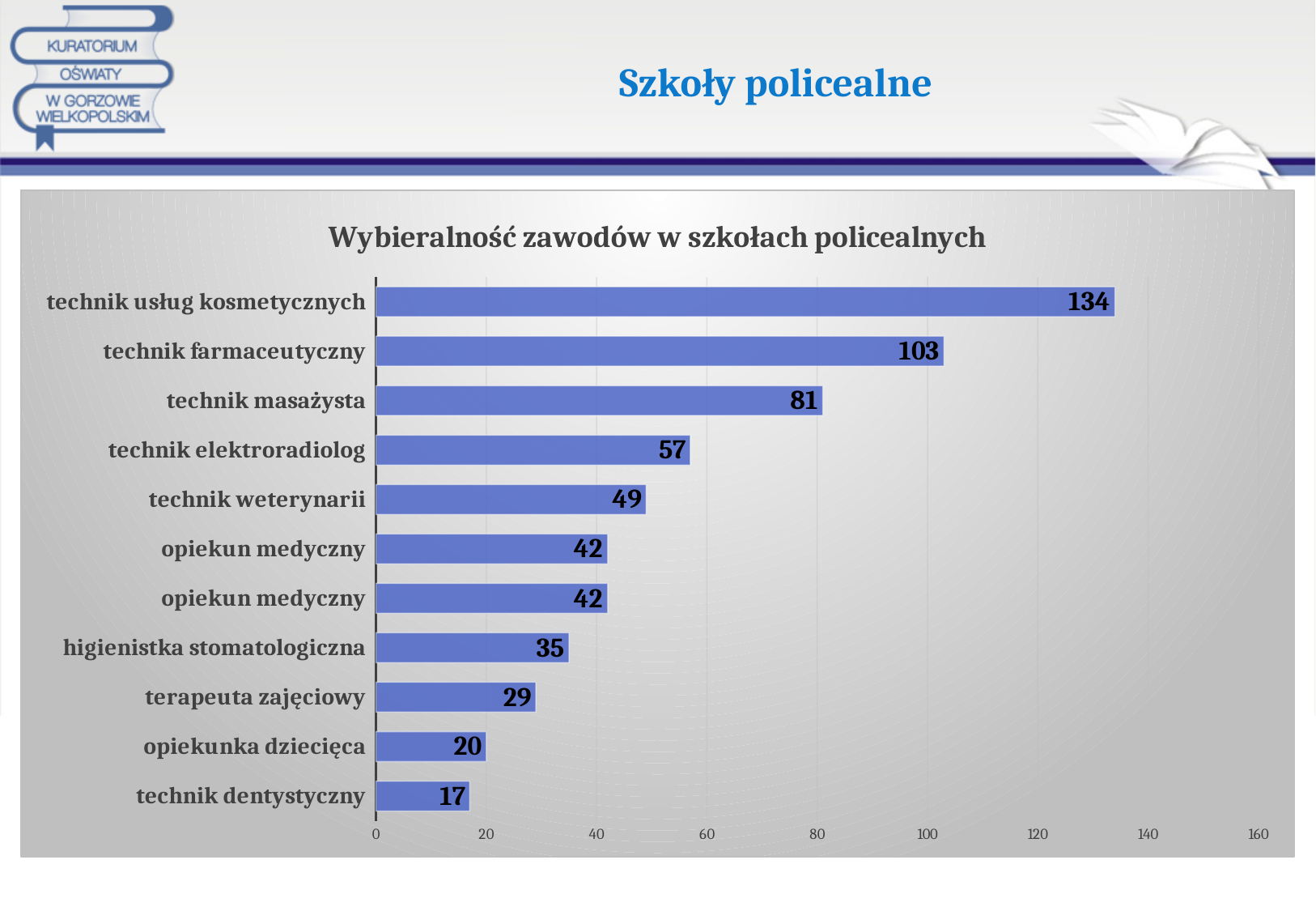
What is the difference between technik farmaceutyczny and technik elektroradiolog? 46 Which category has the highest value? technik usług kosmetycznych Which category has the lowest value? technik dentystyczny What is the value for terapeuta zajęciowy? 29 What kind of chart is shown on the slide? bar chart Is the value for technik farmaceutyczny greater or less than 100? greater What is the value for technik masażysta? 81 How many categories are shown in the chart? 11 What is the difference between technik weterynarii and opiekunka dziecięca? 29 What is the value for technik usług kosmetycznych? 134 Which is larger, higienistka stomatologiczna or technik weterynarii? technik weterynarii What is the title of the chart? Wybieralność zawodów w szkołach policealnych